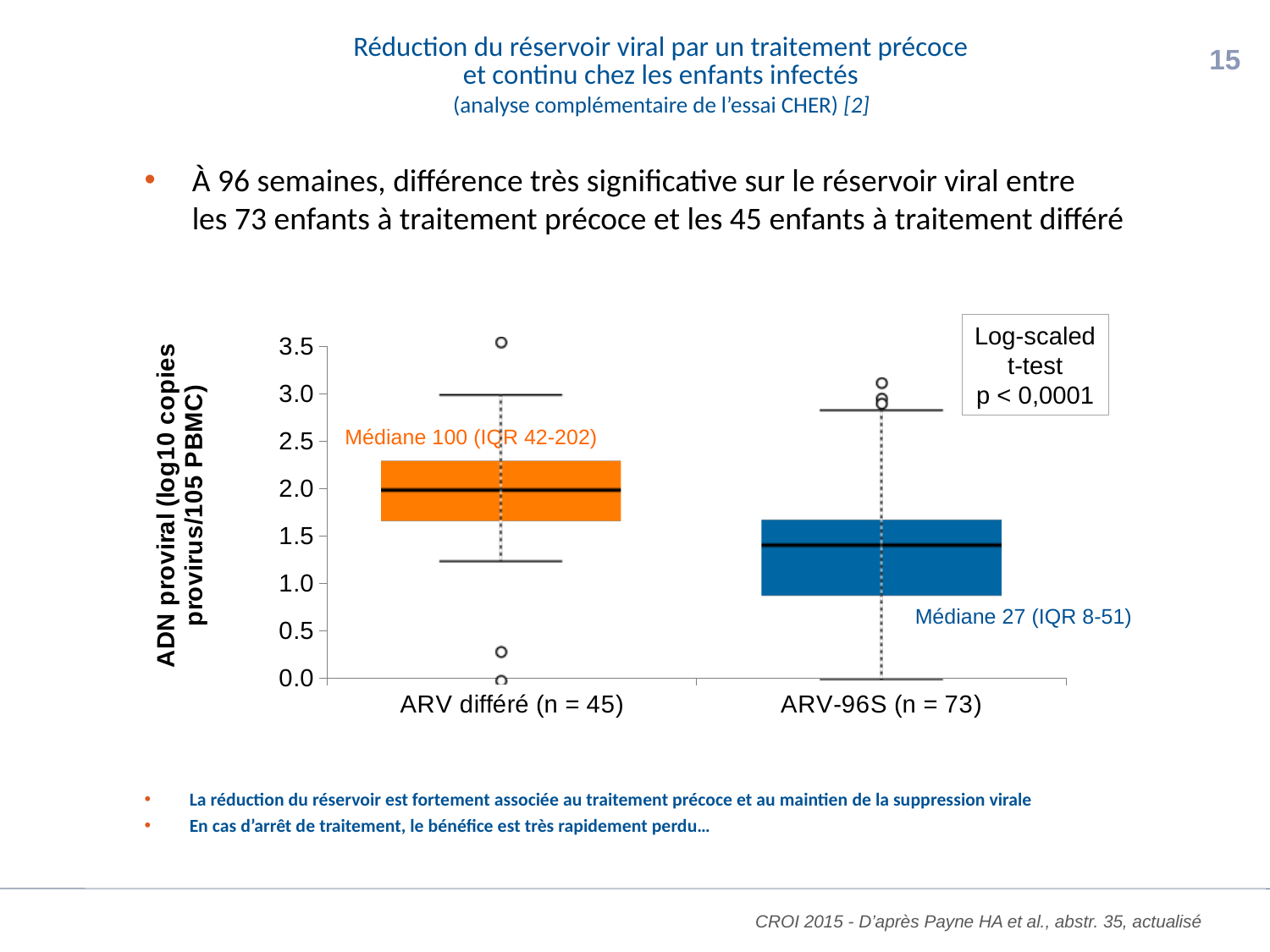
Is the highest outlier point of the ARV différé group greater or less than 3.0 on the y axis? greater What p-value is shown in the box on the chart? p < 0,0001 How many groups are plotted on the x axis? 2 What kind of chart is shown on the slide? Box plot How many children are in the ARV différé group according to the x-axis label? 45 What is the median proviral DNA value annotated for the ARV différé group? 100 (IQR 42-202) Which group has the higher median proviral DNA, ARV différé or ARV-96S? ARV différé What colour is the box for the ARV-96S group? Blue How many children are in the ARV-96S group according to the x-axis label? 73 What is the median proviral DNA value annotated for the ARV-96S group? 27 (IQR 8-51) Is the median line of the ARV différé box greater or less than 1.5 on the y axis? greater What is the difference between the annotated medians of the ARV différé and ARV-96S groups? 73